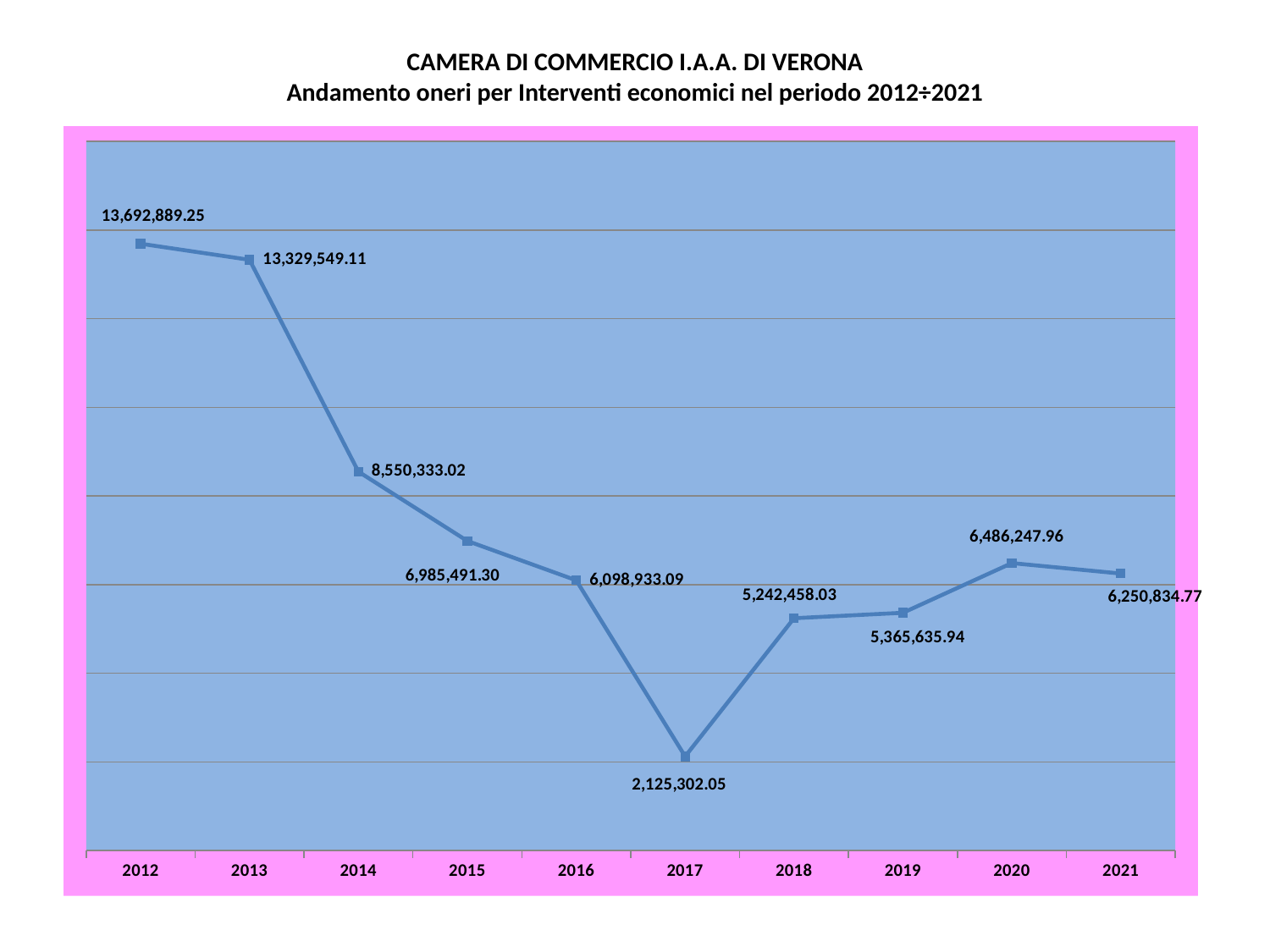
How many years are plotted on the x axis? 10 What is the value for 2014? 8,550,333.02 Which year has the highest value? 2012 Which is larger, the value for 2018 or the value for 2019? 2019 What is the difference between the values for 2020 and 2021? 235,413.19 What is the value for 2021? 6,250,834.77 Do the values rise or fall from 2012 to 2017? fall What kind of chart is shown? line chart What is the value for 2017? 2,125,302.05 What is the difference between the values for 2012 and 2013? 363,340.14 What is the value for 2012? 13,692,889.25 Which year has the lowest value? 2017